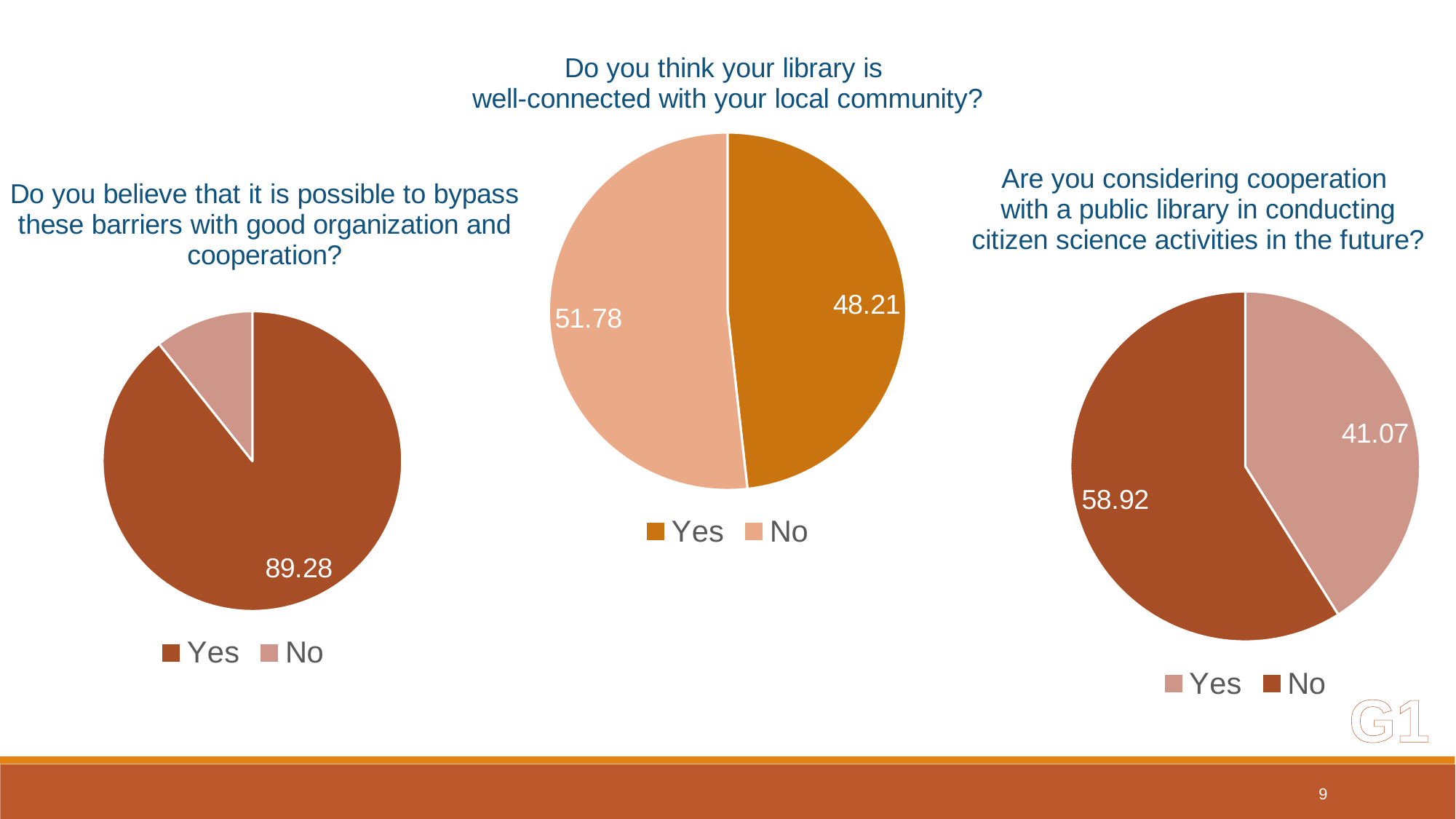
In the right pie chart ("Are you considering cooperation with a public library..."), what is the value for No? 58.92 What type of chart is used for the middle chart ("Do you think your library is well-connected with your local community?")? Pie chart In the middle pie chart ("Do you think your library is well-connected with your local community?"), which slice is larger, Yes or No? No In the middle pie chart ("Do you think your library is well-connected with your local community?"), what is the value for No? 51.78 How many slices does the right pie chart ("Are you considering cooperation with a public library...") have? 2 In the right pie chart ("Are you considering cooperation with a public library..."), which slice is the largest? No In the right pie chart ("Are you considering cooperation with a public library..."), what is the difference between the No and Yes values? 17.85 In the left pie chart ("Do you believe that it is possible to bypass these barriers..."), what is the value for Yes? 89.28 In the middle pie chart ("Do you think your library is well-connected with your local community?"), what is the difference between the No and Yes values? 3.57 In the middle pie chart ("Do you think your library is well-connected with your local community?"), what is the value for Yes? 48.21 In the right pie chart ("Are you considering cooperation with a public library..."), what is the value for Yes? 41.07 In the left pie chart ("Do you believe that it is possible to bypass these barriers..."), which slice is the smallest? No